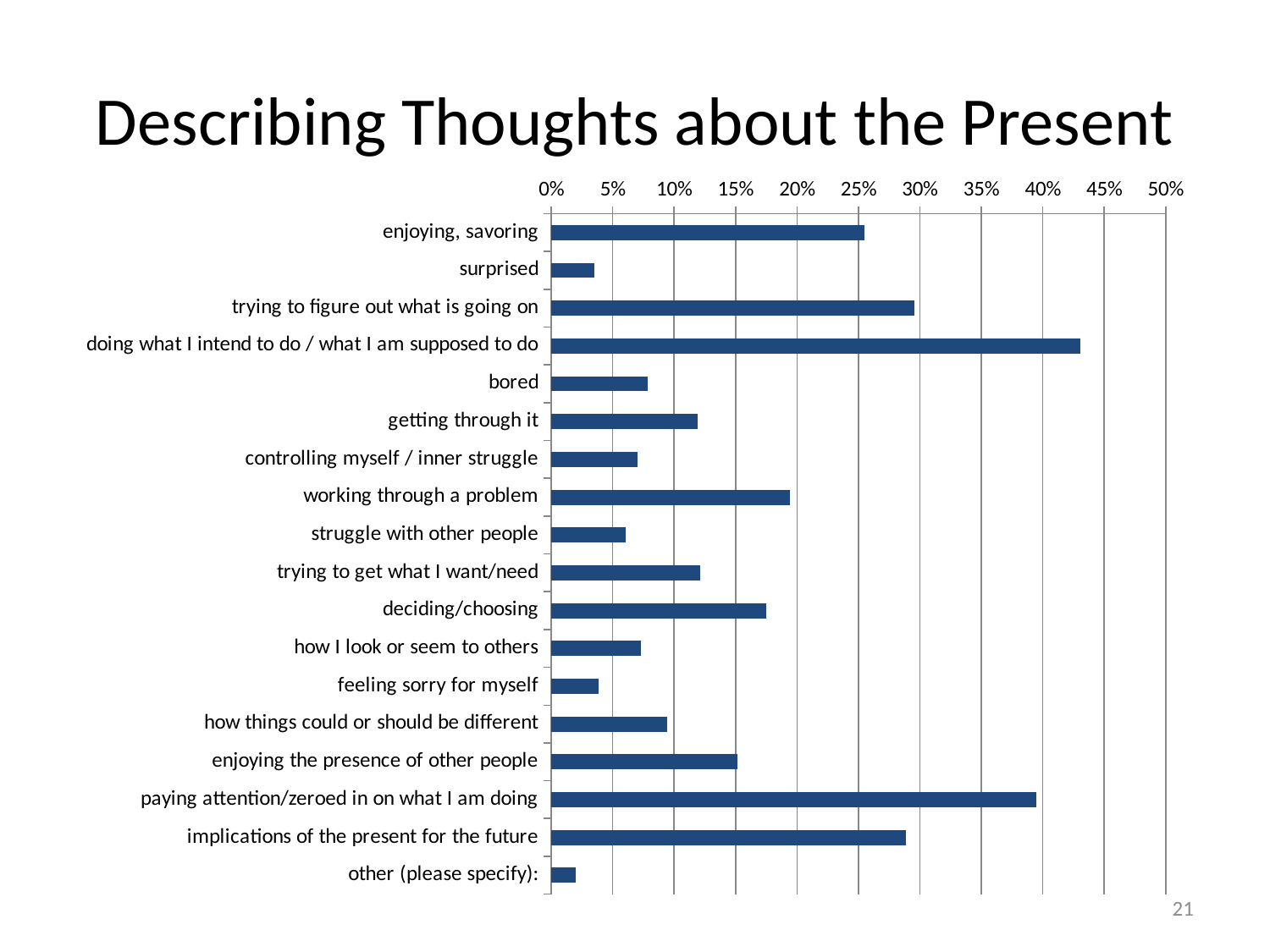
Is the value for 'paying attention/zeroed in on what I am doing' greater or less than 35%? greater Is the value for 'deciding/choosing' greater or less than 15%? greater What kind of chart is shown on the slide? bar chart Is the value for 'bored' greater or less than 10%? less Which is larger: the value for 'getting through it' or the value for 'bored'? getting through it Which category has the highest value? doing what I intend to do / what I am supposed to do Which category has the lowest value? other (please specify): How many categories are plotted in the chart? 18 What is the title of the chart on the slide? Describing Thoughts about the Present Which is larger: the value for 'enjoying, savoring' or the value for 'working through a problem'? enjoying, savoring